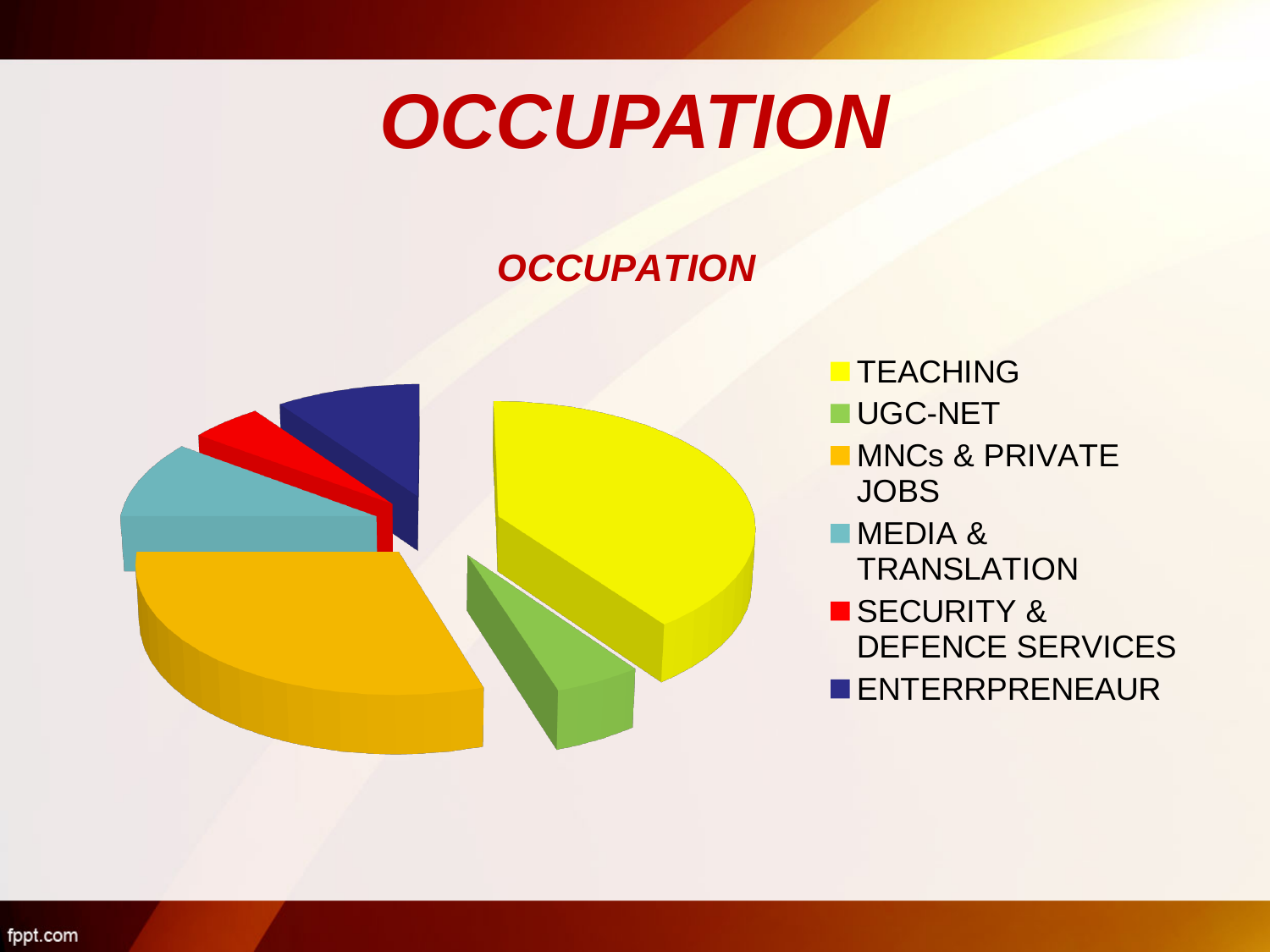
Which slice is larger in the OCCUPATION pie chart, TEACHING or UGC-NET? TEACHING What kind of chart is shown on the slide? pie chart Which slice is larger in the OCCUPATION pie chart, MNCs & PRIVATE JOBS or SECURITY & DEFENCE SERVICES? MNCs & PRIVATE JOBS Which slice is larger in the OCCUPATION pie chart, TEACHING or ENTERRPRENEAUR? TEACHING How many categories does the OCCUPATION pie chart have? 6 What is the title of the pie chart? OCCUPATION Which colour represents UGC-NET in the OCCUPATION pie chart? green